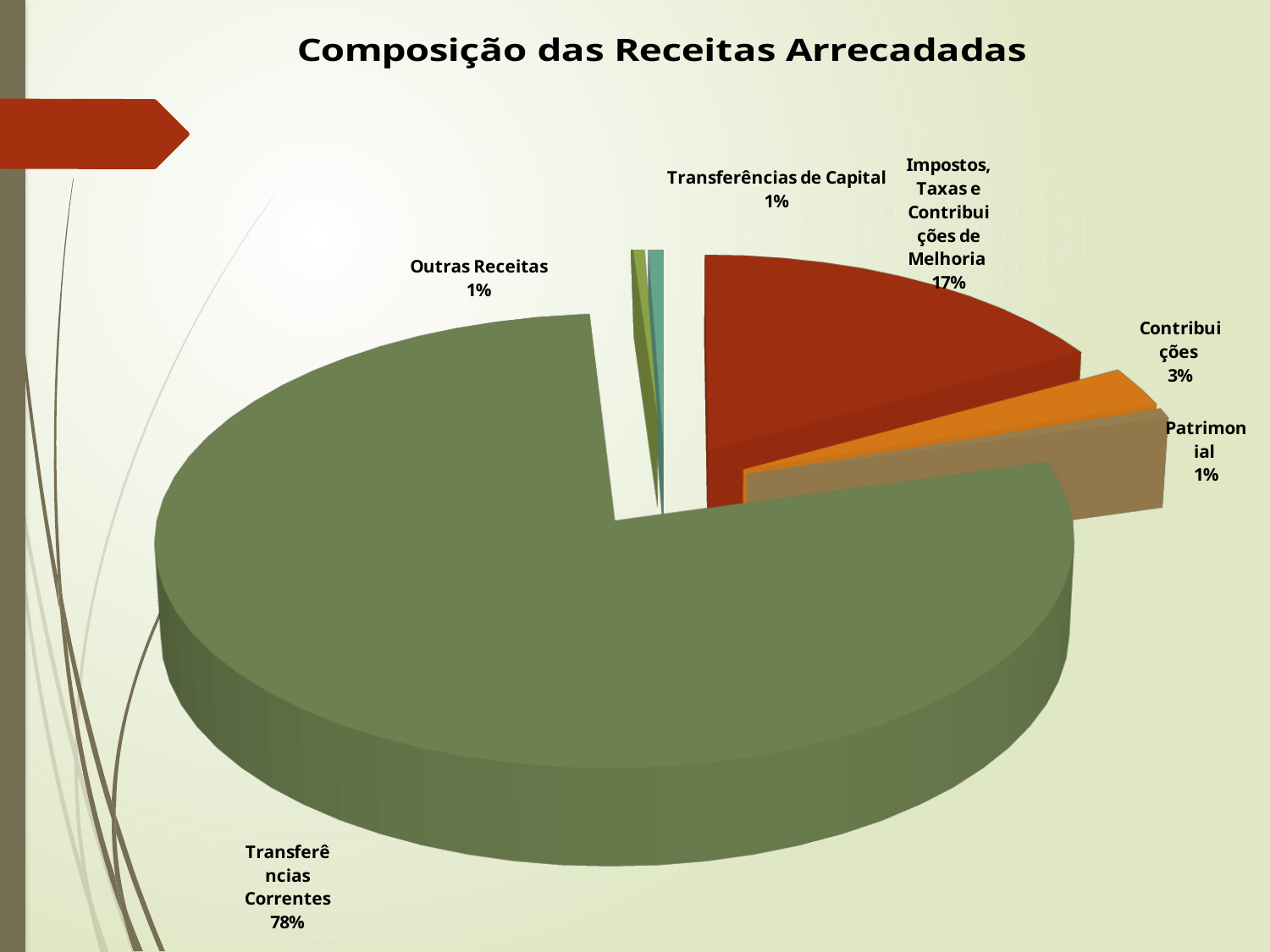
What is the value shown for Outras Receitas? 1% What is the difference between the shares of Impostos, Taxas e Contribuições de Melhoria and Contribuições? 14% Which is larger, the share for Contribuições or the share for Transferências de Capital? Contribuições What is the title of the chart? Composição das Receitas Arrecadadas What share of the pie does Impostos, Taxas e Contribuições de Melhoria represent? 17% What kind of chart is shown on the slide? Pie chart Which category has the largest slice of the pie? Transferências Correntes What is the difference between the shares of Transferências Correntes and Impostos, Taxas e Contribuições de Melhoria? 61% What is the value shown for Contribuições? 3% How many slices does the pie chart have? 6 What share of the pie does Transferências Correntes represent? 78% What is the value shown for Patrimonial? 1%